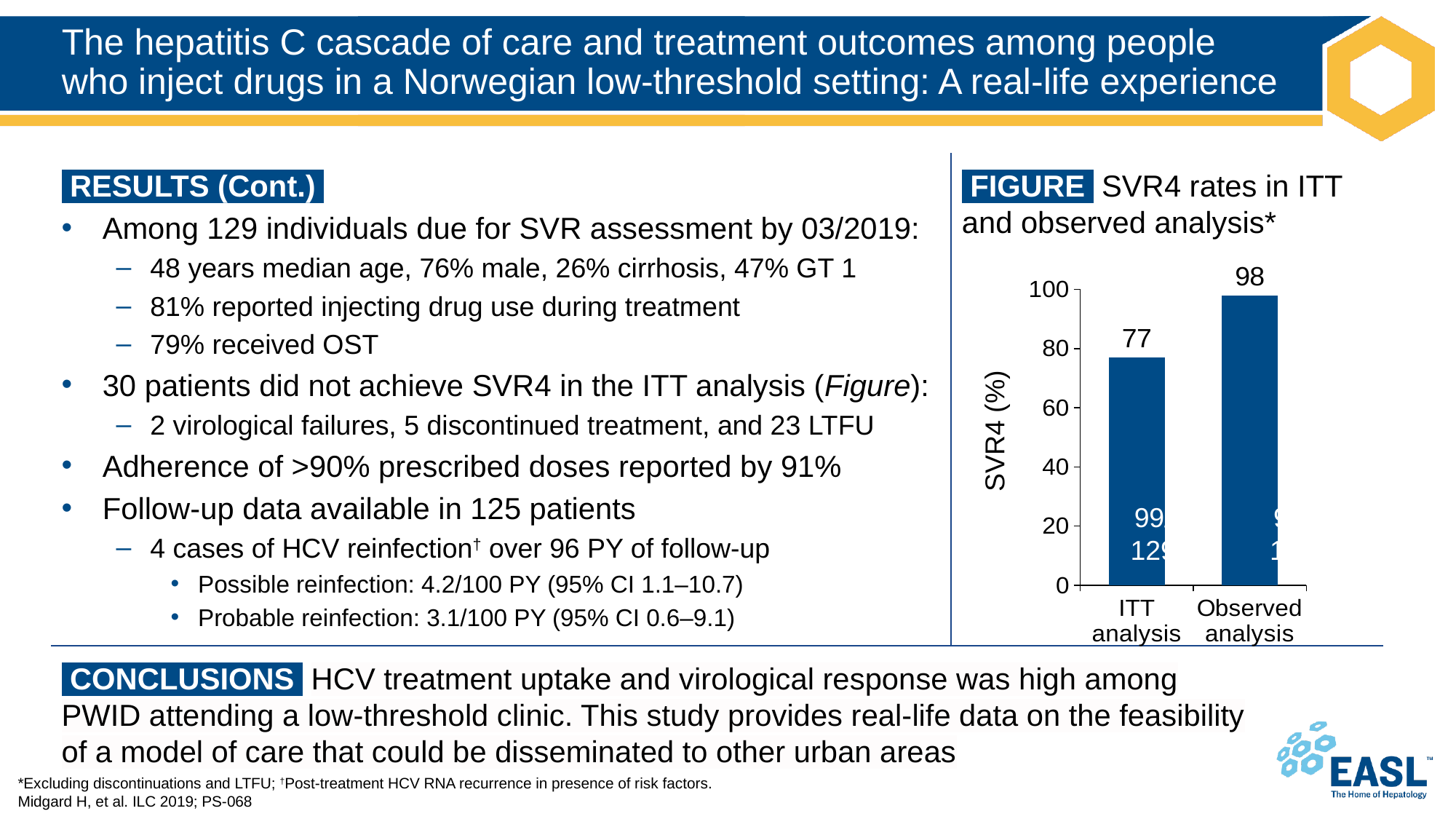
What is the label of the y axis of the chart? SVR4 (%) What type of chart is shown on the slide? Bar chart Which analysis has the lower SVR4 rate? ITT analysis Which analysis has the higher SVR4 rate? Observed analysis How many bars are shown in the chart? 2 What is the SVR4 rate (%) for the Observed analysis? 98 What is the SVR4 rate (%) for the ITT analysis? 77 What is the difference in SVR4 rate between the Observed analysis and the ITT analysis? 21 Is the SVR4 rate for the Observed analysis greater or less than 80? greater What is the title of the figure? SVR4 rates in ITT and observed analysis* Do the values rise or fall from the ITT analysis to the Observed analysis? rise Is the SVR4 rate for the ITT analysis greater or less than 80? less